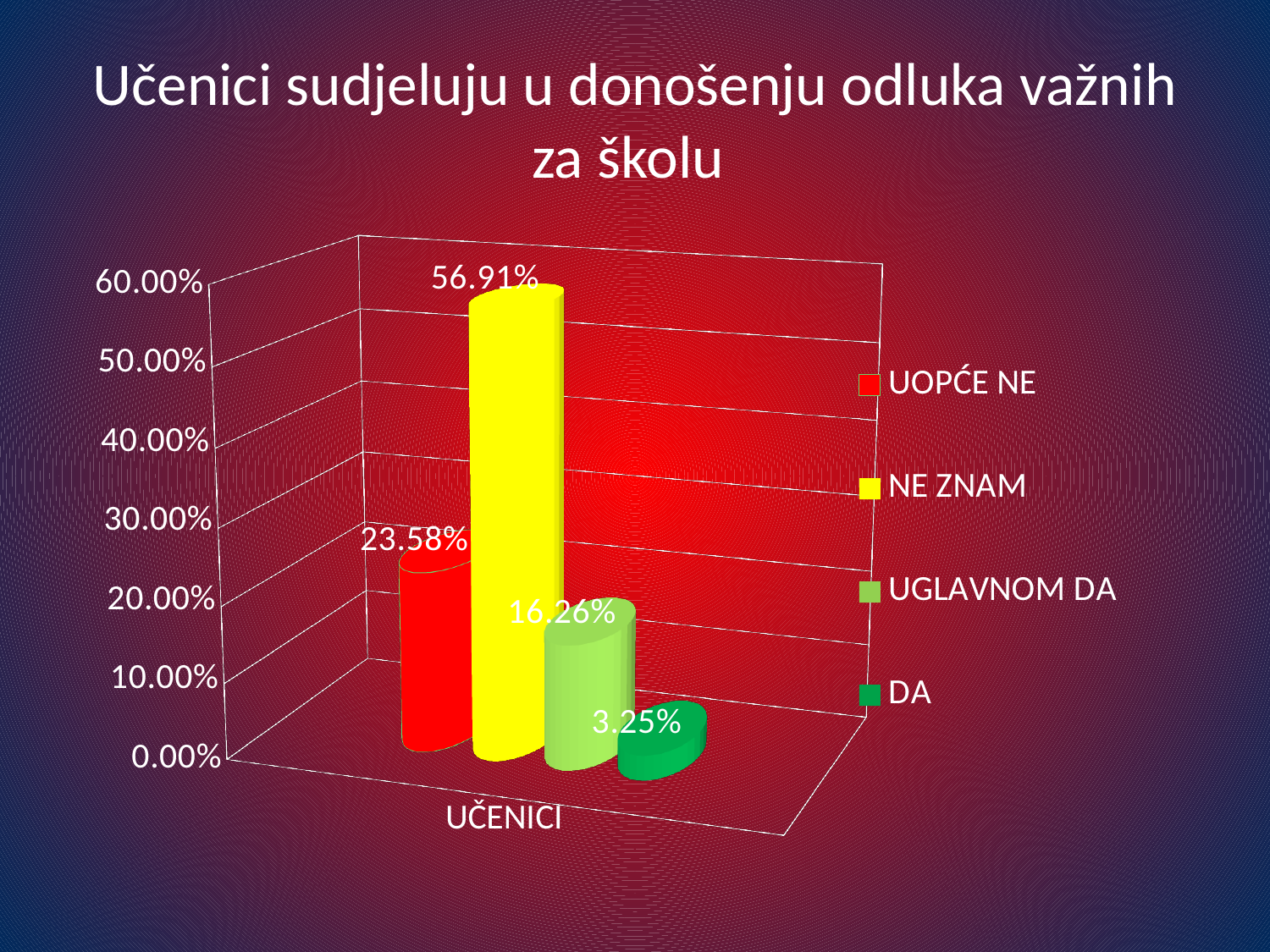
Which series has the highest value? NE ZNAM Which is larger, the value for UOPĆE NE or the value for UGLAVNOM DA? UOPĆE NE What is the category label on the x axis? UČENICI What is the value for DA? 3.25% What is the value for NE ZNAM? 56.91% What is the value for UOPĆE NE? 23.58% What kind of chart is shown on the slide? bar chart Which series has the lowest value? DA What is the difference between the values for NE ZNAM and UOPĆE NE? 33.33% How many series does the legend list? 4 Is the value for UGLAVNOM DA greater or less than 20.00%? less What is the value for UGLAVNOM DA? 16.26%